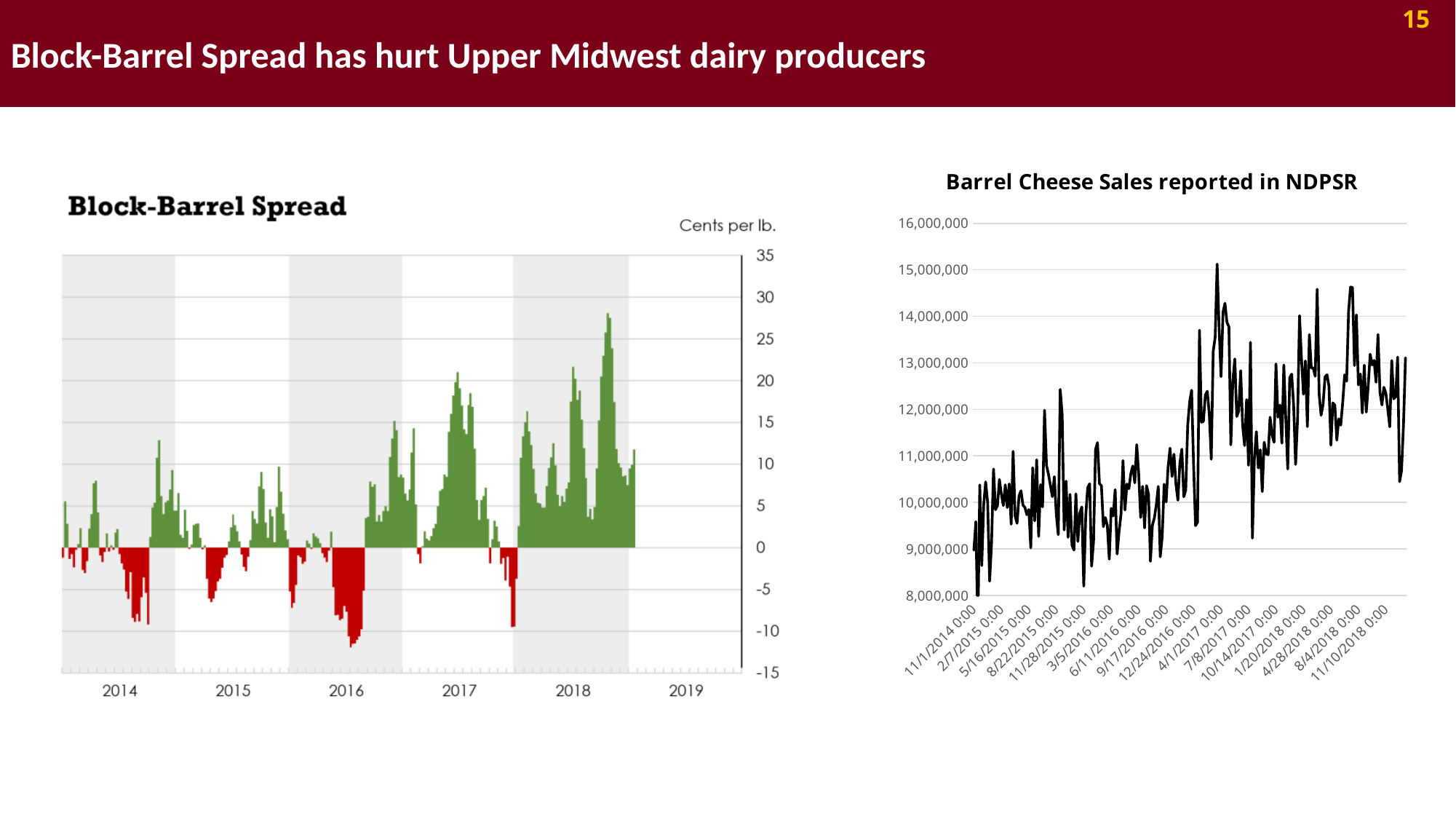
In the Block-Barrel Spread chart, what colour are the bars for negative spread values? red What kind of chart is the Block-Barrel Spread chart? bar chart In the Barrel Cheese Sales reported in NDPSR chart, is the highest value greater or less than 14,000,000? greater How many year labels are shown on the x axis of the Block-Barrel Spread chart? 6 In the Block-Barrel Spread chart, is the highest spread value greater or less than 25 cents per lb? greater In the Block-Barrel Spread chart, in which year does the spread reach its highest value? 2018 In the Barrel Cheese Sales reported in NDPSR chart, is the value at 11/1/2014 greater or less than 10,000,000? less What unit is shown on the y axis of the Block-Barrel Spread chart? Cents per lb. In the Barrel Cheese Sales reported in NDPSR chart, do the values generally rise or fall from 2014 to 2018? rise What kind of chart is the Barrel Cheese Sales reported in NDPSR chart? line chart In the Block-Barrel Spread chart, in which year does the spread reach its lowest value? 2016